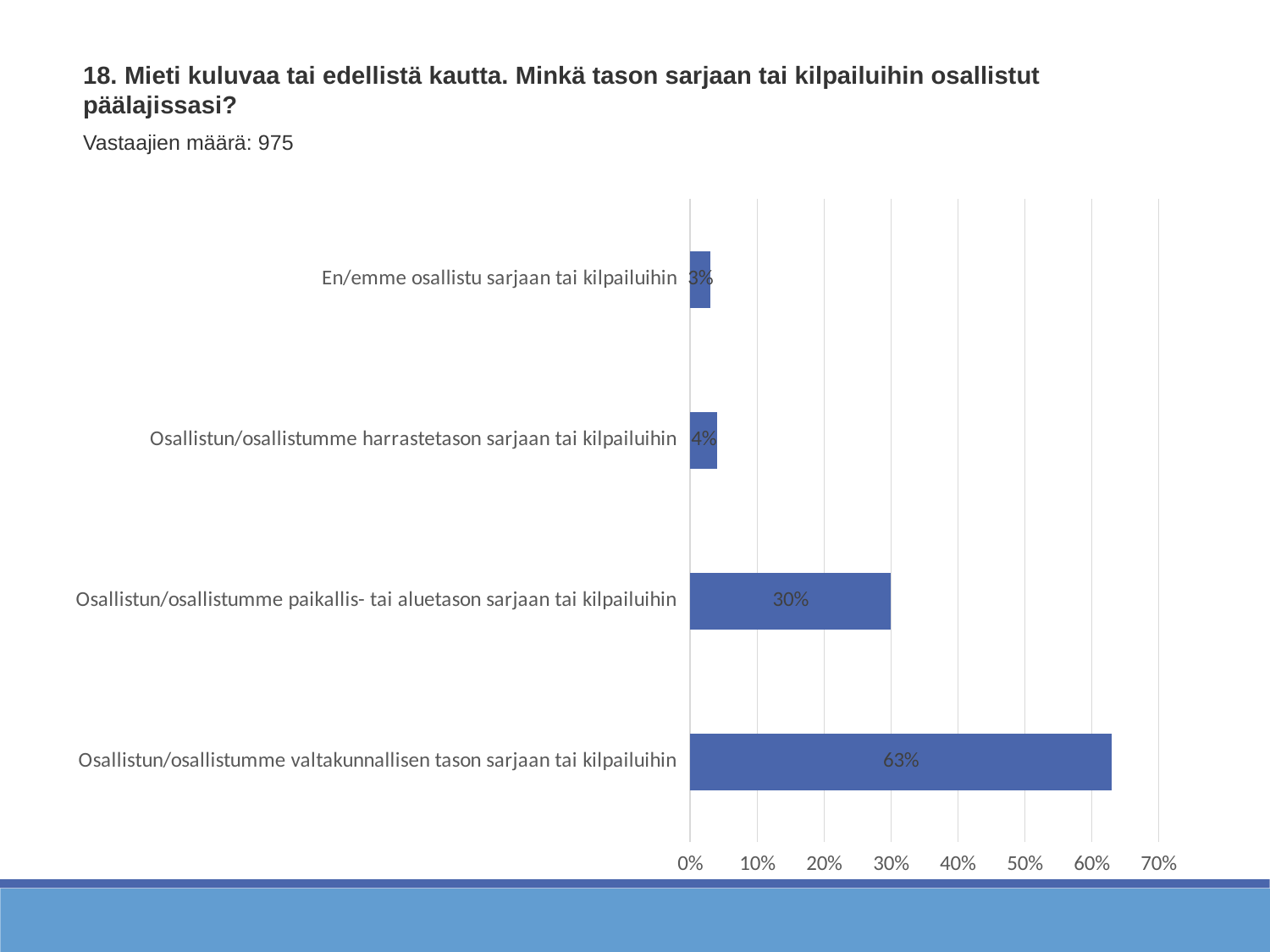
What is the value for "Osallistun/osallistumme paikallis- tai aluetason sarjaan tai kilpailuihin"? 30% What is the difference between the values for the valtakunnallisen tason category and the paikallis- tai aluetason category? 33% How many respondents (Vastaajien määrä) are reported on the slide? 975 Is the value for "Osallistun/osallistumme valtakunnallisen tason sarjaan tai kilpailuihin" greater or less than 50%? greater Which is larger: the value for the paikallis- tai aluetason category or the harrastetason category? Osallistun/osallistumme paikallis- tai aluetason sarjaan tai kilpailuihin What kind of chart is shown on the slide? bar chart What is the value for "En/emme osallistu sarjaan tai kilpailuihin"? 3% What percentage of respondents chose "Osallistun/osallistumme valtakunnallisen tason sarjaan tai kilpailuihin"? 63% How many categories are shown in the chart? 4 Which category has the highest value? Osallistun/osallistumme valtakunnallisen tason sarjaan tai kilpailuihin Which category has the lowest value? En/emme osallistu sarjaan tai kilpailuihin What is the value for "Osallistun/osallistumme harrastetason sarjaan tai kilpailuihin"? 4%